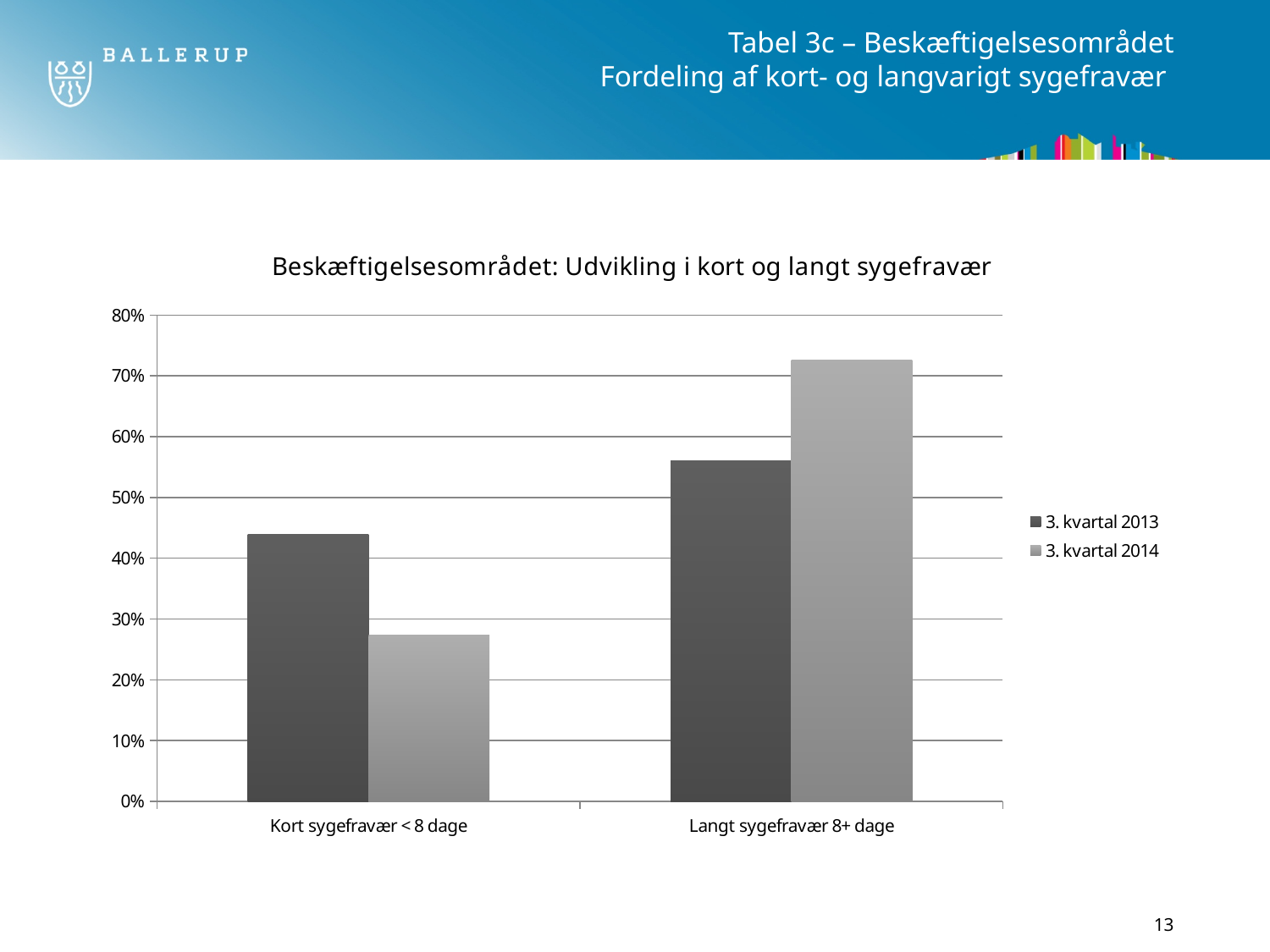
What kind of chart is shown on the slide? bar chart Is the value for Kort sygefravær < 8 dage in 3. kvartal 2013 greater or less than 40%? greater Which bar is the tallest in the chart? Langt sygefravær 8+ dage, 3. kvartal 2014 What is the title of the chart? Beskæftigelsesområdet: Udvikling i kort og langt sygefravær How many series does the legend list? 2 Is the value for Kort sygefravær < 8 dage in 3. kvartal 2014 greater or less than 30%? less Which series does the legend list first? 3. kvartal 2013 Which is larger for Kort sygefravær < 8 dage: 3. kvartal 2013 or 3. kvartal 2014? 3. kvartal 2013 Which is larger for Langt sygefravær 8+ dage: 3. kvartal 2013 or 3. kvartal 2014? 3. kvartal 2014 Is the value for Langt sygefravær 8+ dage in 3. kvartal 2013 greater or less than 60%? less How many categories are shown on the x axis? 2